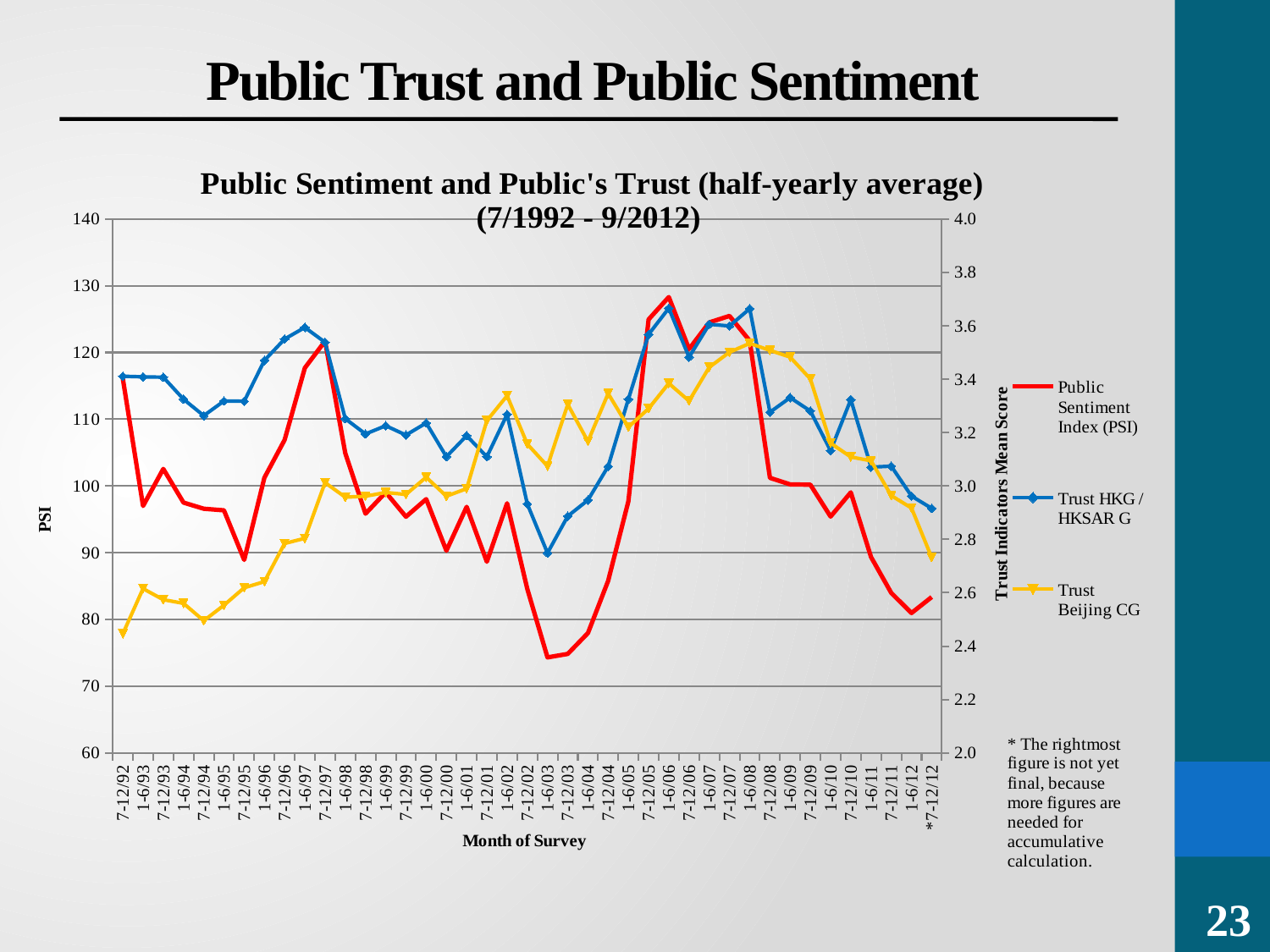
Does the Public Sentiment Index (PSI) rise or fall between 1-6/08 and 1-6/12? Fall Is the Public Sentiment Index (PSI) value at 1-6/03 greater or less than 80? less At which survey period does the Public Sentiment Index (PSI) reach its lowest value? 1-6/03 How many series does the chart legend list? 3 Is the Trust Beijing CG value at 7-12/92 greater or less than 2.6? less At which survey period does the Public Sentiment Index (PSI) reach its highest value? 1-6/06 Is the Public Sentiment Index (PSI) value at 1-6/06 greater or less than 120? greater At which survey period is the Trust Beijing CG series at its lowest? 7-12/92 What kind of chart is shown on the slide? Line chart What is the title of the x axis? Month of Survey At 7-12/92, which is larger: Trust HKG / HKSAR G or Trust Beijing CG? Trust HKG / HKSAR G What is the title of the chart? Public Sentiment and Public's Trust (half-yearly average) (7/1992 - 9/2012)